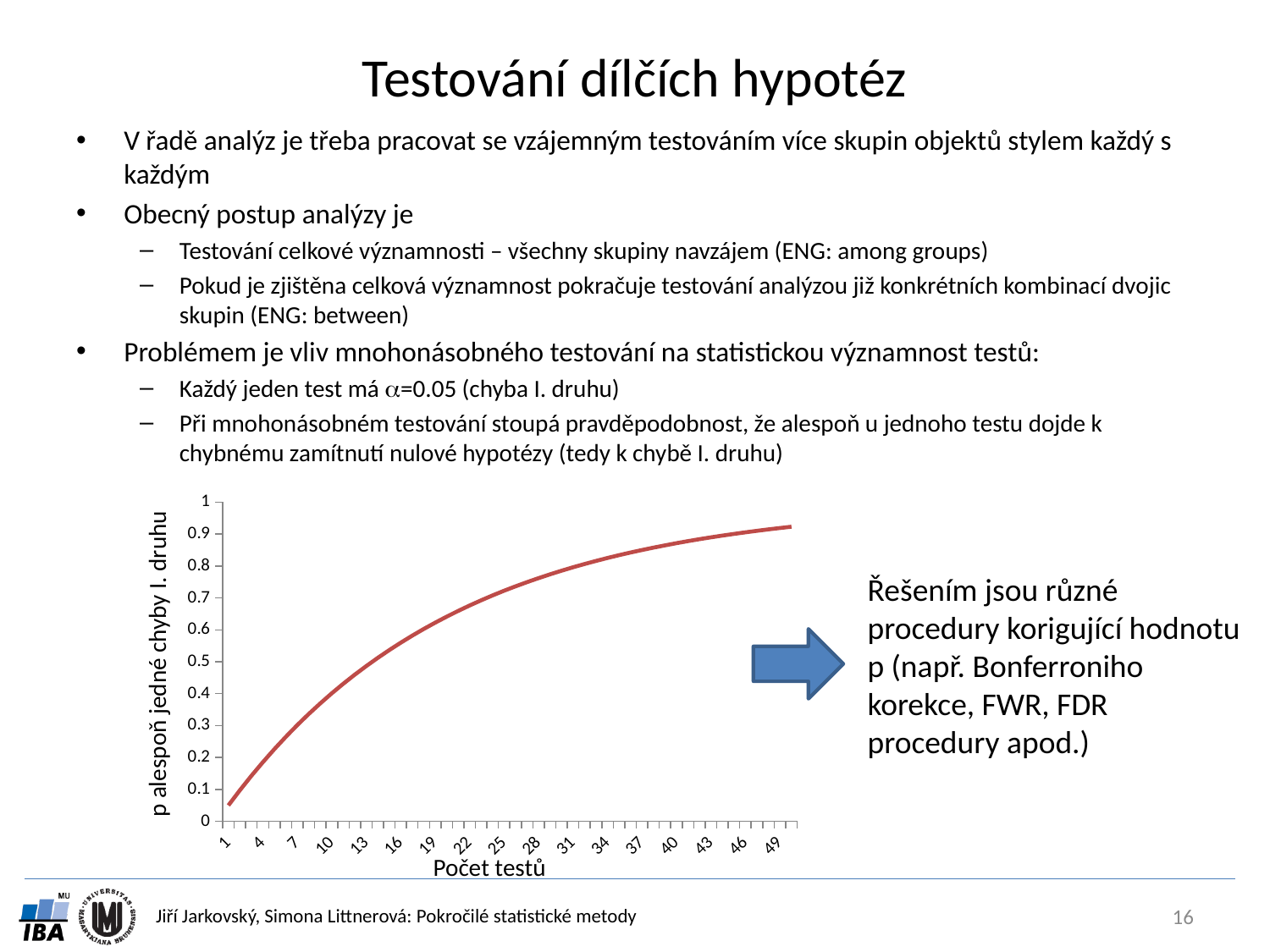
Is the value of the line at 22 tests greater or less than 0.6? greater Is the value of the line at 4 tests greater or less than 0.3? less What is the largest tick label shown on the x axis of the chart? 49 What kind of chart is shown on the slide? line chart What is the label of the y axis of the chart? p alespoň jedné chyby I. druhu Is the value of the line at 10 tests greater or less than 0.3? greater Does the plotted line rise or fall as the number of tests (Počet testů) increases? rises What is the label of the x axis of the chart? Počet testů How many lines are plotted on the chart? 1 What is the highest value shown on the y axis of the chart? 1